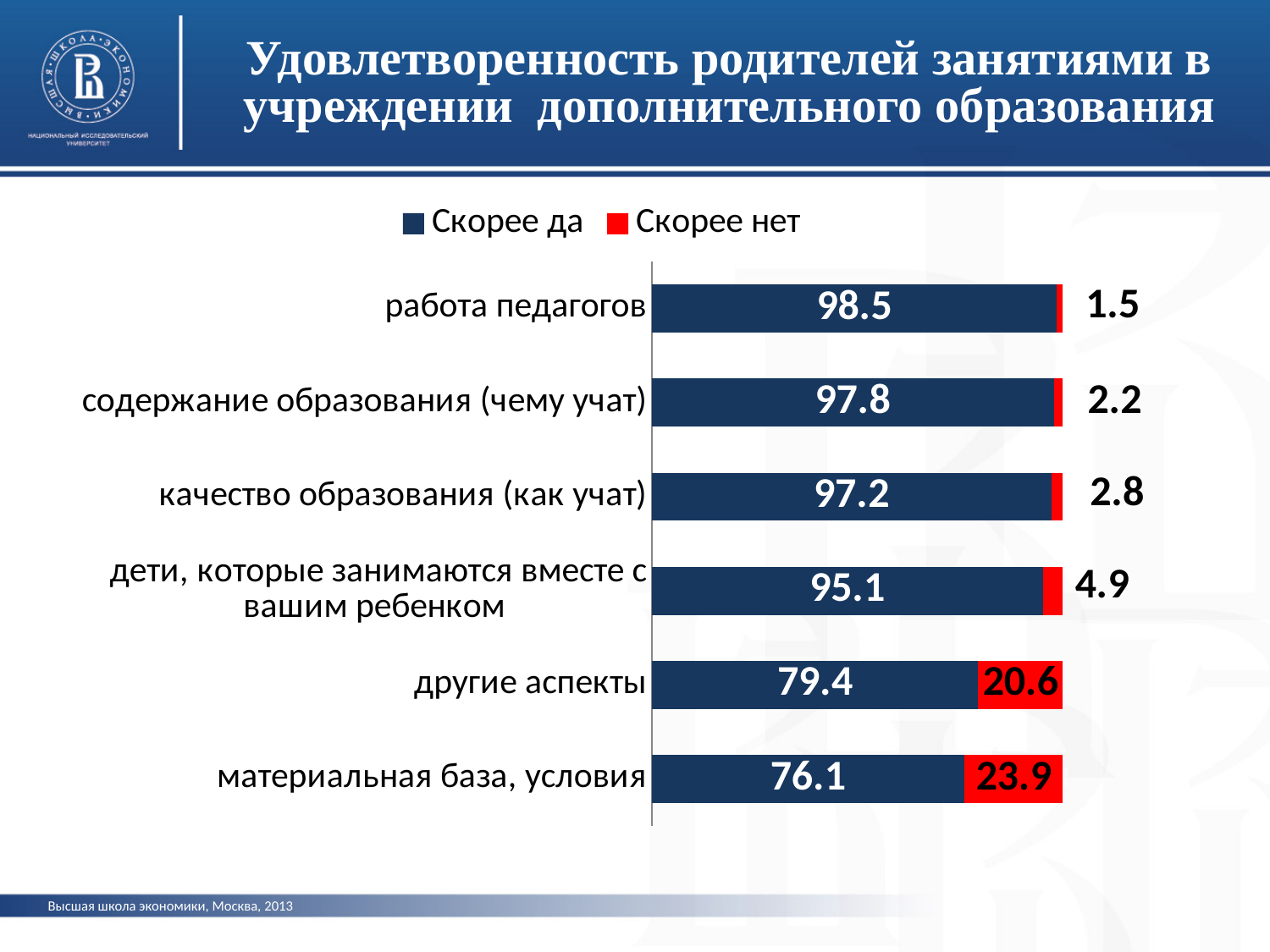
How many categories are shown in the chart? 6 What is the difference between the "Скорее нет" values for "материальная база, условия" and "другие аспекты"? 3.3 How many series does the legend list? 2 Which is larger: the "Скорее да" value for "содержание образования (чему учат)" or for "качество образования (как учат)"? содержание образования (чему учат) Which category has the highest "Скорее нет" value? материальная база, условия Which category has the highest "Скорее да" value? работа педагогов What is the "Скорее да" value for "другие аспекты"? 79.4 What is the "Скорее да" value for "работа педагогов"? 98.5 Which category has the lowest "Скорее да" value? материальная база, условия What is the "Скорее нет" value for "дети, которые занимаются вместе с вашим ребенком"? 4.9 What is the "Скорее нет" value for "материальная база, условия"? 23.9 What type of chart is shown on the slide? Stacked bar chart